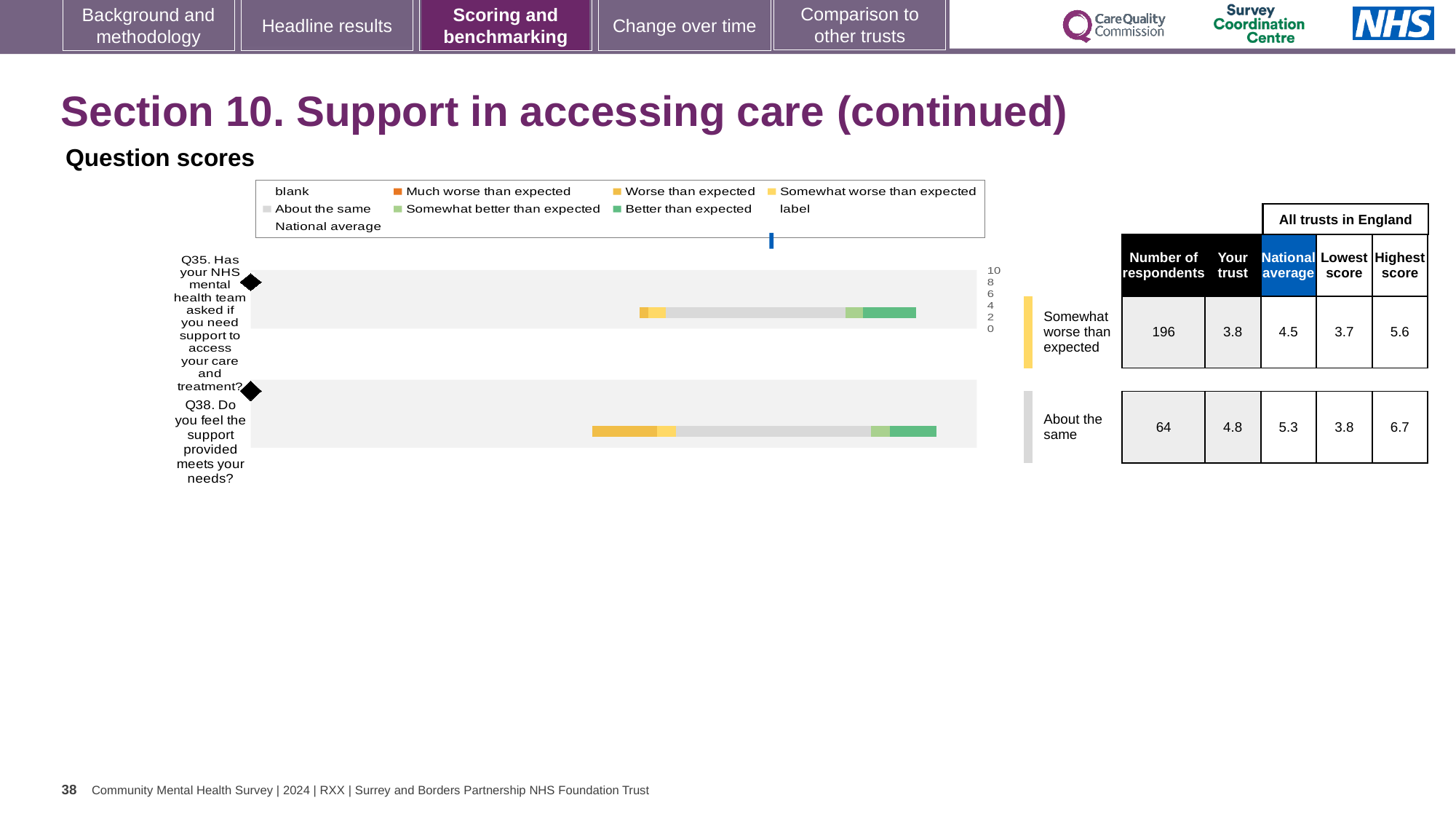
What is the 'Your trust' score for Q35 (Has your NHS mental health team asked if you need support to access your care and treatment?)? 3.8 What is the highest score among all trusts in England for Q38? 6.7 How many questions are plotted in the question scores chart? 2 For Q35, which is larger: the 'Your trust' score or the national average? National average What is the difference between the national average (4.5) and the 'Your trust' score (3.8) for Q35? 0.7 What is the national average score for Q38 (Do you feel the support provided meets your needs?)? 5.3 What is the difference between the highest score (6.7) and the lowest score (3.8) for Q38? 2.9 What colour does the legend use for 'Better than expected'? Green What kind of chart is used to show the question scores on this slide? bar chart Which rating category is shown for Q35's trust score? Somewhat worse than expected Which question had more respondents, Q35 or Q38? Q35 How many respondents answered Q35? 196